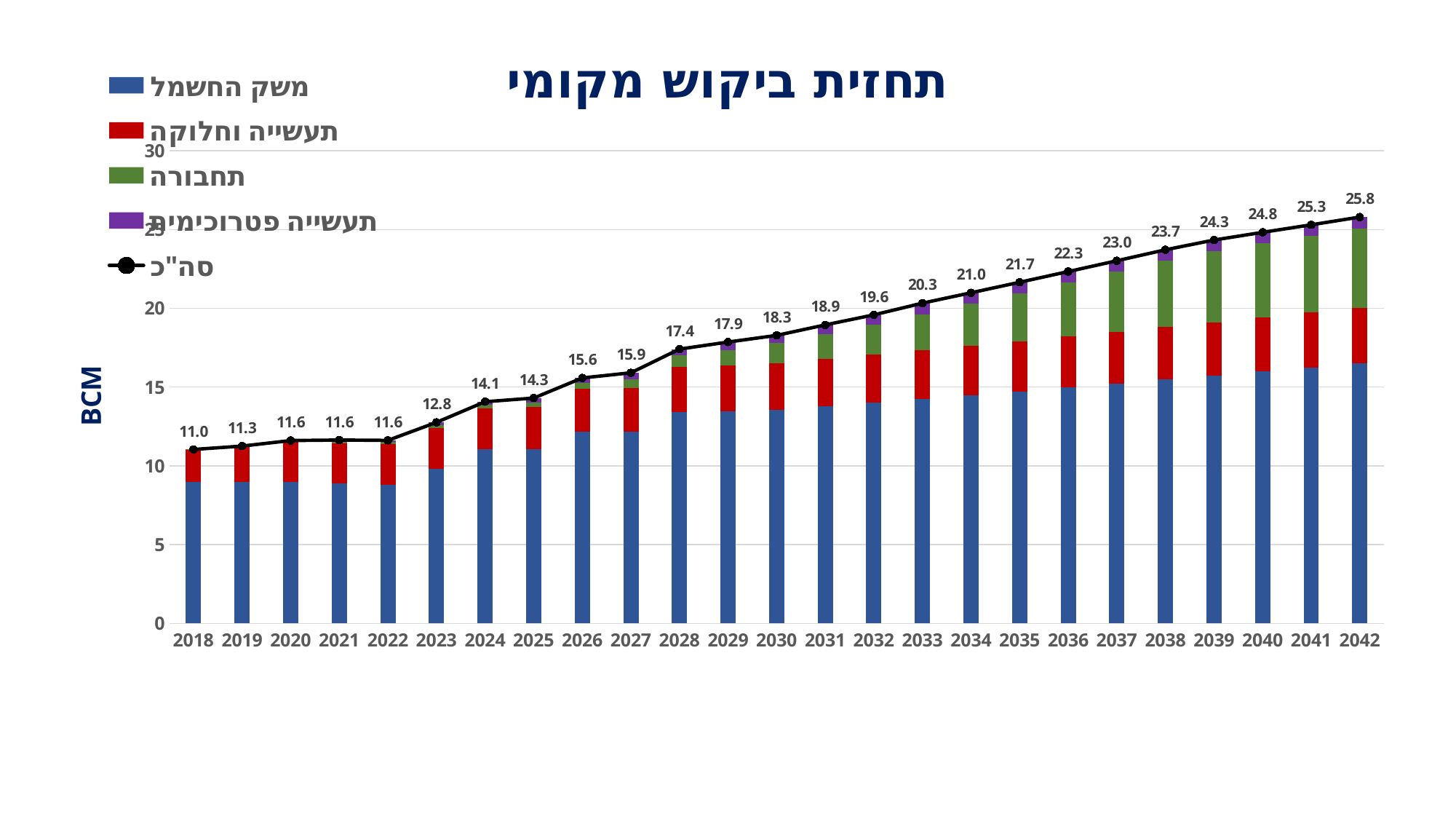
Which year has the highest total value? 2042 Which year has a larger total, 2028 or 2035? 2035 What is the difference between the total for 2042 and the total for 2018? 14.8 How many series does the legend list? 5 What is the total (סה"כ) value for 2018? 11.0 Is the value of the משק החשמל segment for 2042 greater or less than 15? greater Which year has the lowest total value? 2018 What kind of chart is shown on the slide? Stacked bar chart with a line What is the total (סה"כ) value for 2030? 18.3 How many years are shown on the x axis? 25 What is the total (סה"כ) value for 2042? 25.8 Do the total values rise or fall from 2018 to 2042? Rise